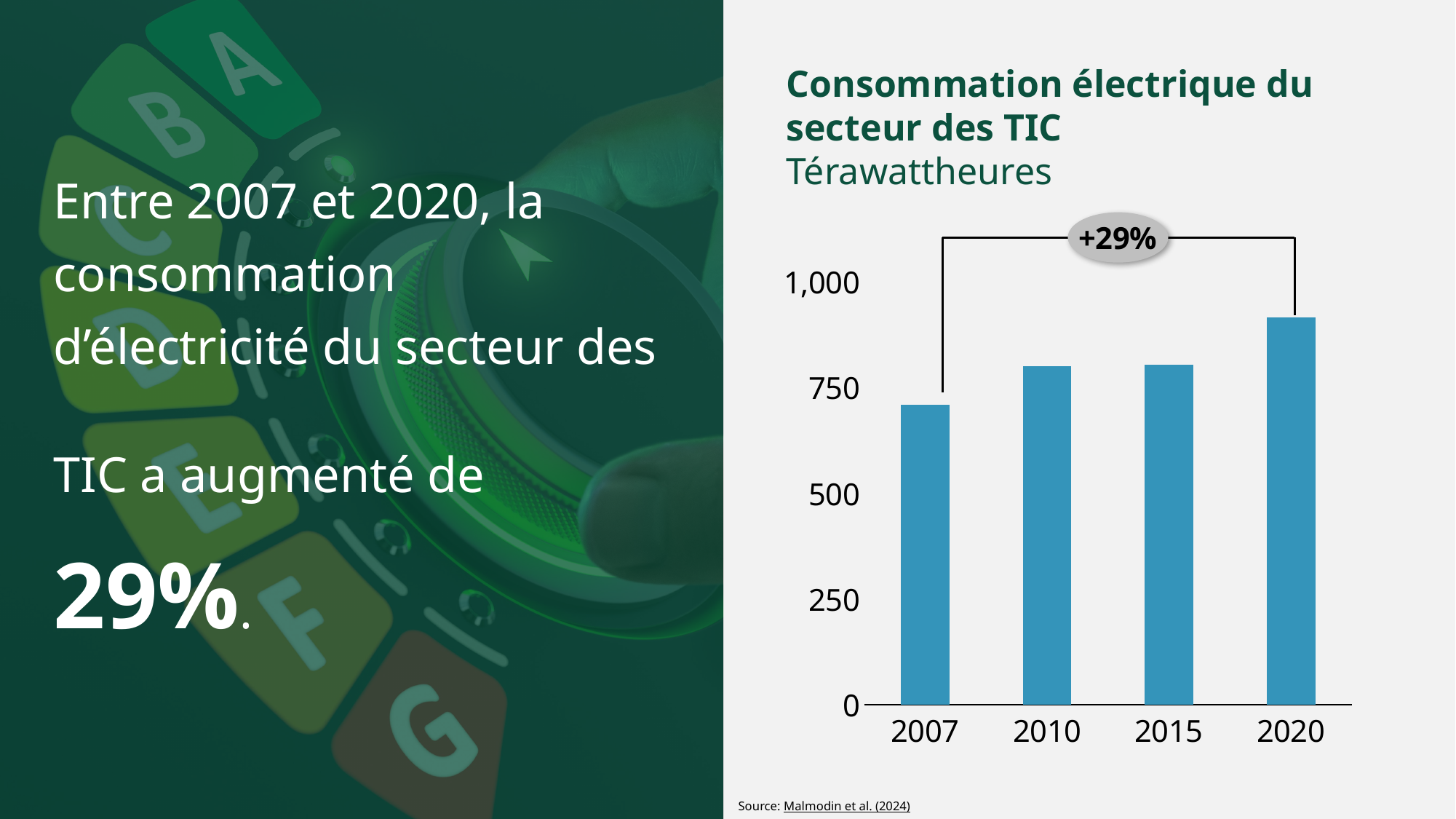
What percentage change between 2007 and 2020 is annotated on the chart? +29% How many years are plotted on the chart? 4 Is the value for 2007 greater or less than 750? less What kind of chart is shown on the slide? bar chart Which is larger, the value for 2007 or the value for 2020? 2020 Do the values generally rise or fall from 2007 to 2020? rise Is the value for 2020 greater or less than 1,000? less Is the value for 2015 greater or less than 500? greater In what unit is the electricity consumption expressed on the chart? Térawattheures Which year has the lowest electricity consumption on the chart? 2007 Which year has the highest electricity consumption on the chart? 2020